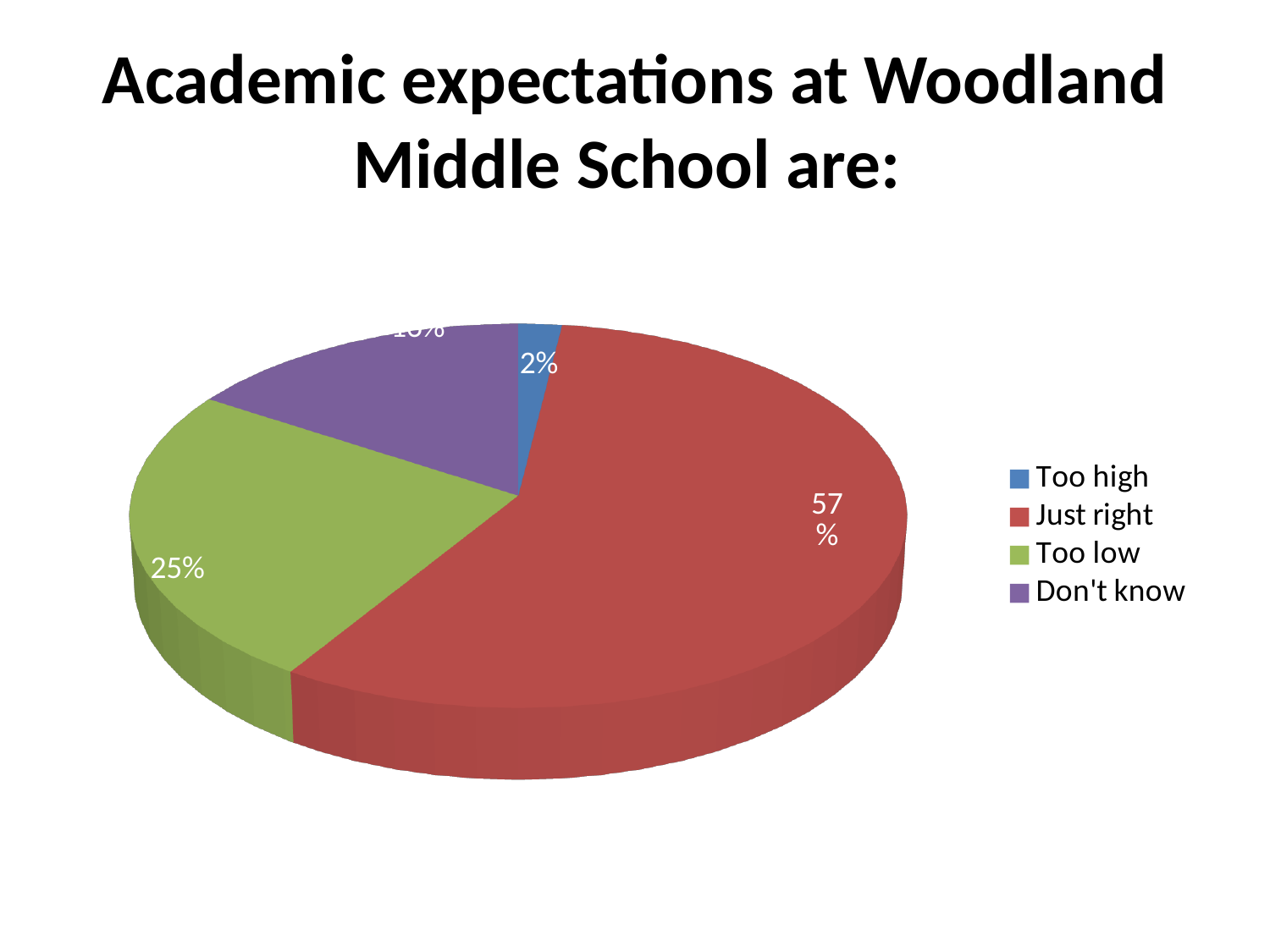
Which category has the smallest slice of the pie? Too high What is the difference in percentage points between 'Just right' and 'Too low'? 32 Which is larger, the share for 'Too low' or the share for 'Don't know'? Too low What kind of chart is shown on the slide? pie chart How many categories does the legend list? 4 What percentage of respondents said academic expectations are 'Too high'? 2% Which category has the largest slice of the pie? Just right What is the title of the chart? Academic expectations at Woodland Middle School are: What colour is the 'Just right' slice? red Which is larger, the share for 'Too high' or the share for 'Too low'? Too low What percentage of respondents said academic expectations are 'Too low'? 25% What percentage of respondents said academic expectations are 'Just right'? 57%